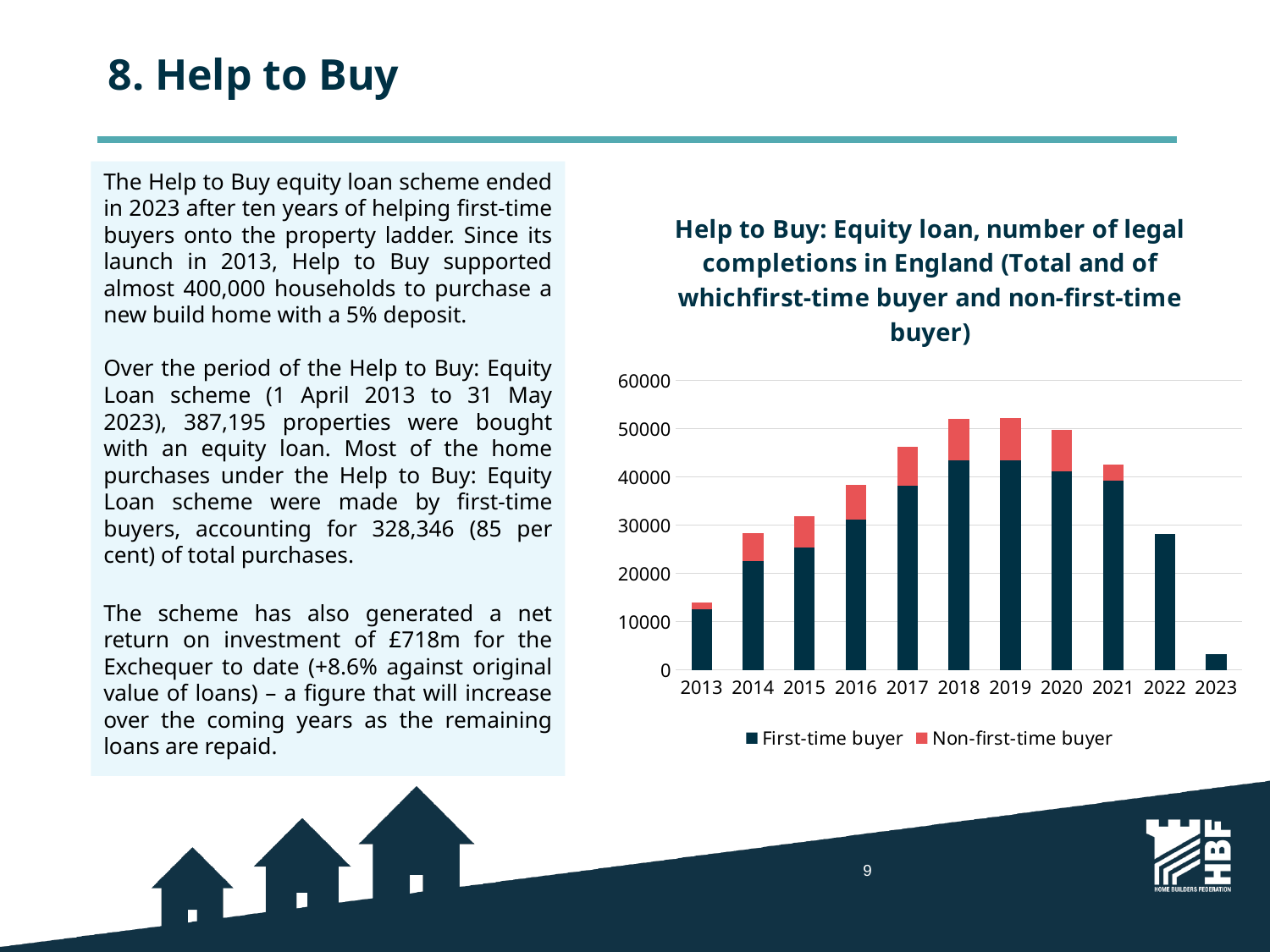
Do the total completions rise or fall from 2019 to 2023? fall Is the total value for 2023 greater or less than 10000? less How many series does the chart's legend list? 2 Which year has the lowest total number of legal completions in the chart? 2023 Which series is shown in red in the chart? Non-first-time buyer Which year has the larger total number of completions, 2015 or 2017? 2017 Is the total value for 2017 greater or less than 40000? greater What kind of chart is shown on the slide? Stacked bar chart Is the total value for 2021 greater or less than 40000? greater How many years are shown on the x axis of the chart? 11 Which year has the larger total number of completions, 2021 or 2022? 2021